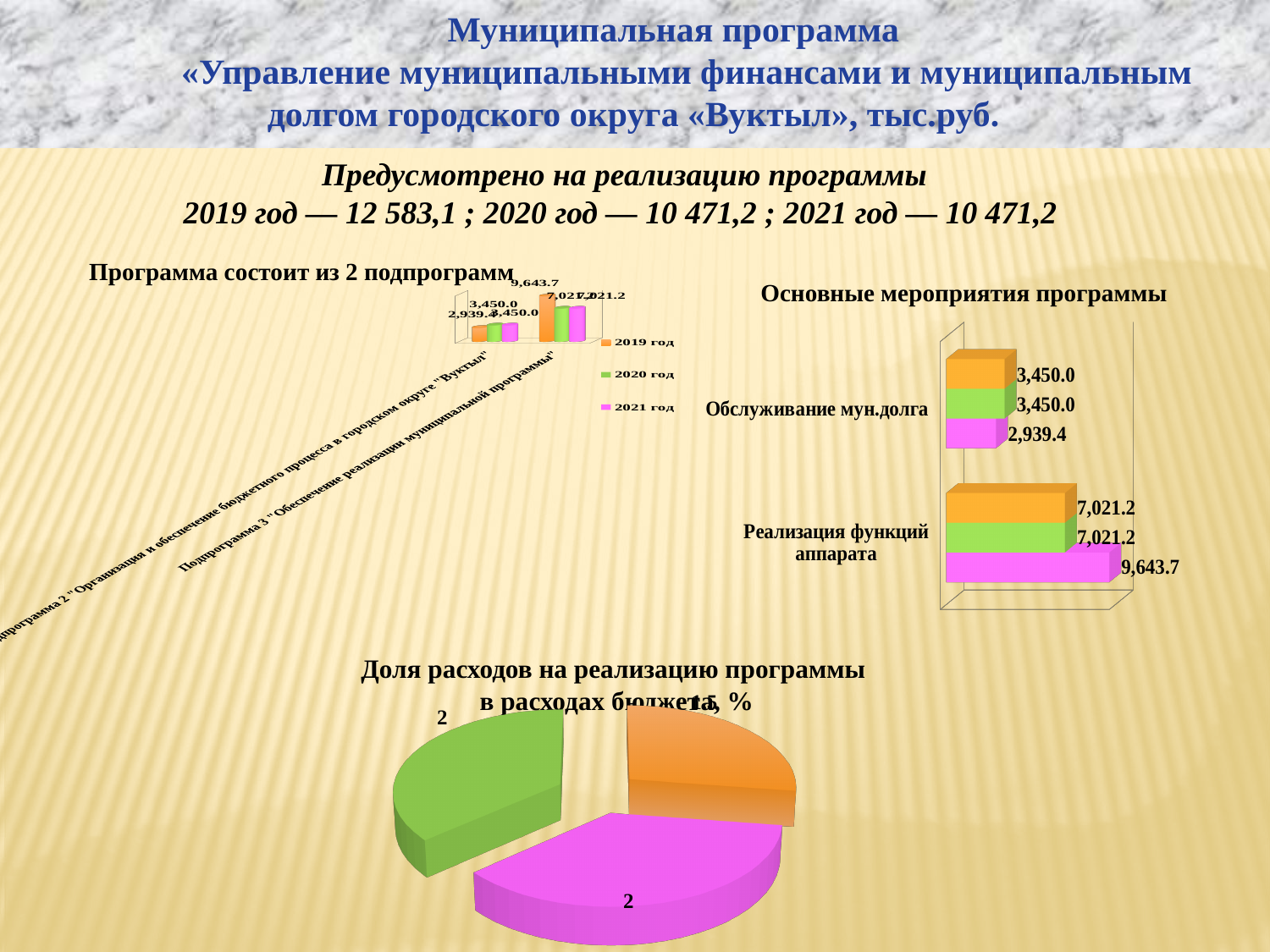
What kind of chart is the "Доля расходов на реализацию программы в расходах бюджета, %" chart? pie chart In the "Основные мероприятия программы" chart, what is the difference between the pink bar (9,643.7) and the orange bar (7,021.2) for "Реализация функций аппарата"? 2,622.5 How many series does the legend of the top-left chart ("Программа состоит из 2 подпрограмм") list? 3 What are the legend entries of the top-left chart ("Программа состоит из 2 подпрограмм")? 2019 год, 2020 год, 2021 год In the "Основные мероприятия программы" chart, which category has the highest value? Реализация функций аппарата In the "Основные мероприятия программы" chart, what is the value of the pink bar for "Реализация функций аппарата"? 9,643.7 What kind of chart is the "Основные мероприятия программы" chart? bar chart In the "Основные мероприятия программы" chart, what is the value of the pink bar for "Обслуживание мун.долга"? 2,939.4 In the top-left chart ("Программа состоит из 2 подпрограмм"), what is the value for 2019 год for Подпрограмма 3 "Обеспечение реализации муниципальной программы"? 9,643.7 How many slices does the "Доля расходов на реализацию программы в расходах бюджета, %" pie chart have? 3 How many categories are shown in the "Основные мероприятия программы" chart? 2 In the "Основные мероприятия программы" chart, what is the difference between the orange bar (3,450.0) and the pink bar (2,939.4) for "Обслуживание мун.долга"? 510.6